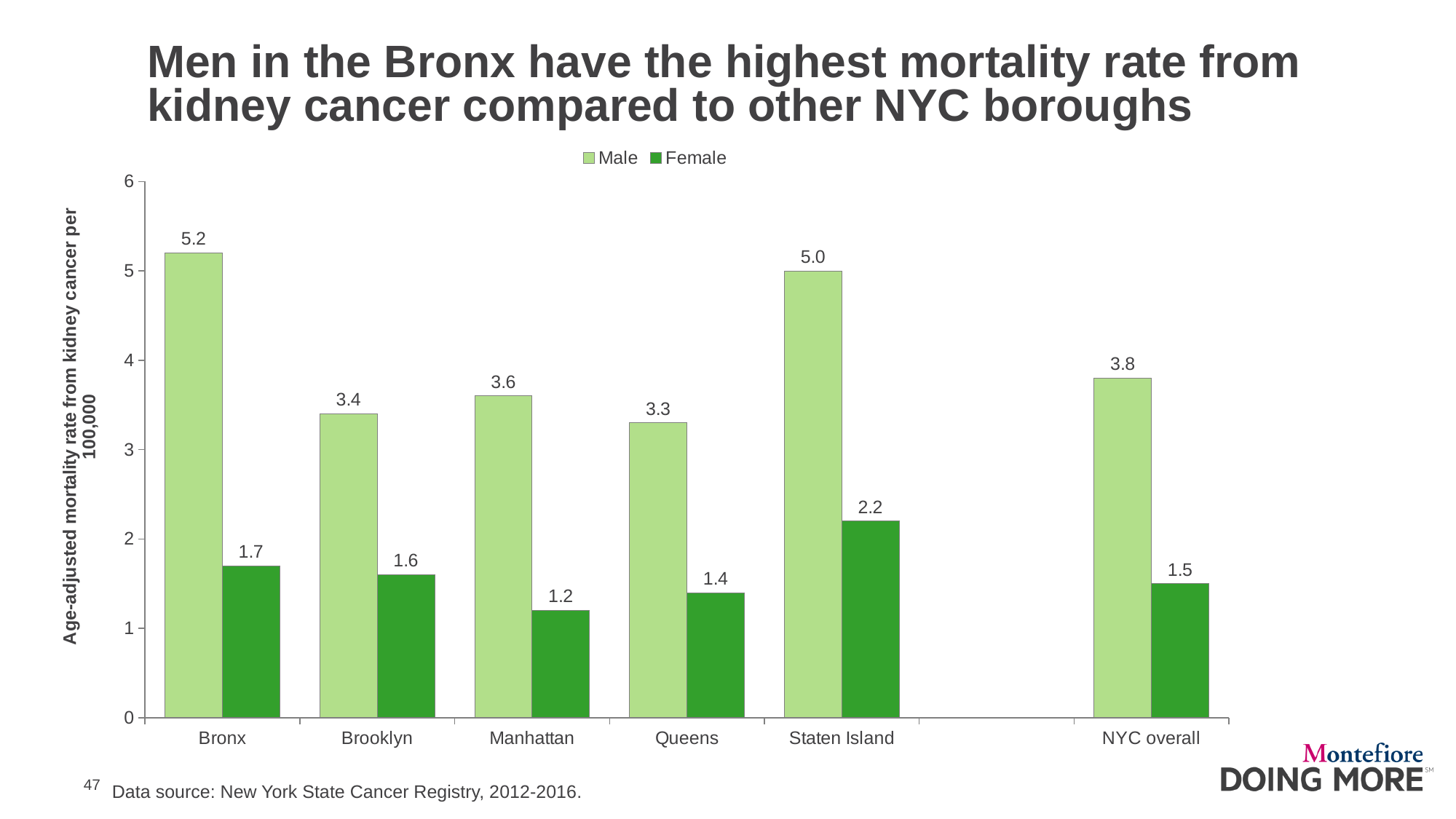
What is the Female mortality rate for Staten Island? 2.2 How many categories are shown on the x axis? 6 Which borough has the highest Male mortality rate? Bronx What is the Male value for NYC overall? 3.8 What is the difference between the Male and Female values for the Bronx? 3.5 How many series does the legend list? 2 Is the Male value for Staten Island greater or less than 4? greater Which category has the lowest Female mortality rate? Manhattan Which is larger, the Male value for Brooklyn or the Male value for Manhattan? Manhattan What is the Male mortality rate for the Bronx? 5.2 What is the data source cited on the slide? New York State Cancer Registry, 2012-2016 What kind of chart is shown on the slide? Bar chart